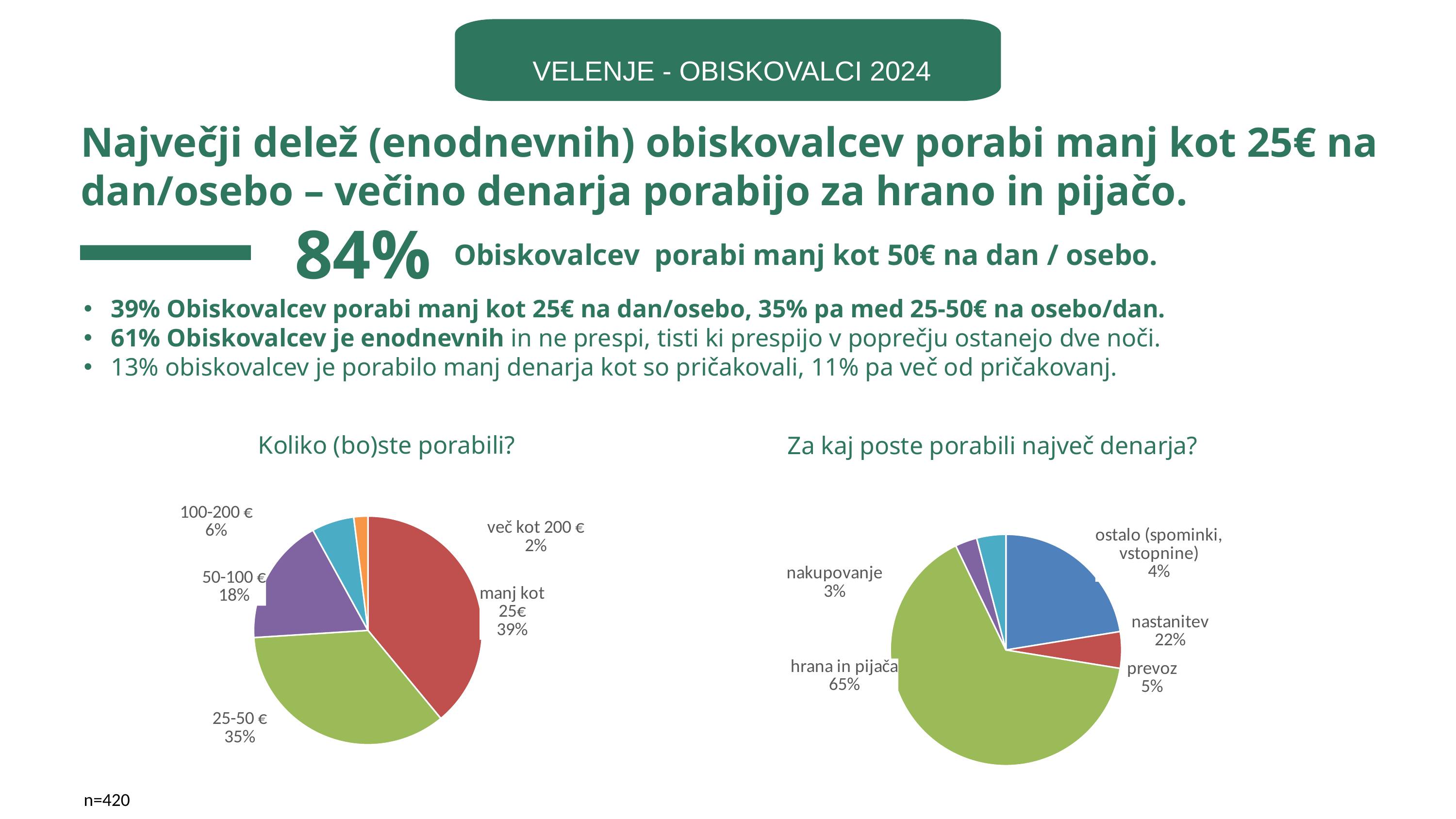
In the chart titled "Koliko (bo)ste porabili?", how many categories are shown? 5 In the chart titled "Koliko (bo)ste porabili?", which category has the smallest share? več kot 200 € In the chart titled "Za kaj poste porabili največ denarja?", which is larger: "prevoz" or "ostalo (spominki, vstopnine)"? prevoz What type of chart is the chart titled "Za kaj poste porabili največ denarja?"? Pie chart In the chart titled "Za kaj poste porabili največ denarja?", which category has the smallest share? nakupovanje In the chart titled "Koliko (bo)ste porabili?", which category has the largest share? manj kot 25€ In the chart titled "Za kaj poste porabili največ denarja?", what is the value for "nastanitev"? 22% In the chart titled "Koliko (bo)ste porabili?", what is the difference between the shares for "25-50 €" and "50-100 €"? 17% In the chart titled "Koliko (bo)ste porabili?", what share of visitors spend "manj kot 25€"? 39% In the chart titled "Za kaj poste porabili največ denarja?", what is the difference between "hrana in pijača" and "nastanitev"? 43% In the chart titled "Koliko (bo)ste porabili?", what is the value for "50-100 €"? 18% In the chart titled "Za kaj poste porabili največ denarja?", which category has the largest share? hrana in pijača